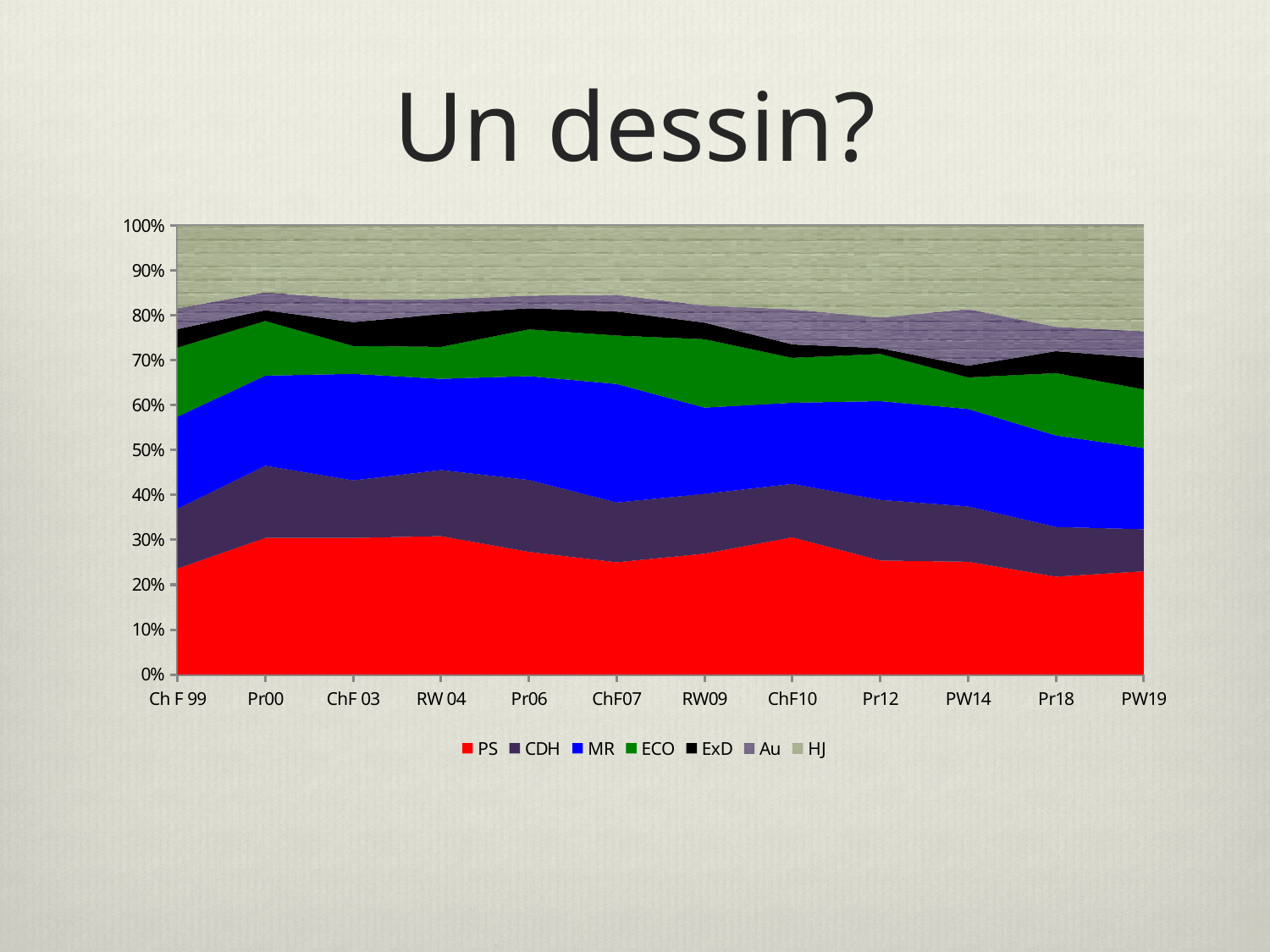
What kind of chart is shown on the slide? area chart Is the value for PS at Pr18 greater or less than 10%? greater Is the value for PS at Pr12 greater or less than 20%? greater Which series is plotted at the bottom of the stacked area chart? PS Is the value for PS at Ch F 99 greater or less than 20%? greater How many categories are shown along the x axis? 12 Which is larger, the value for PS at Pr00 or the value for PS at Pr18? Pr00 How many series does the legend list? 7 What is the title of the slide containing the chart? Un dessin?